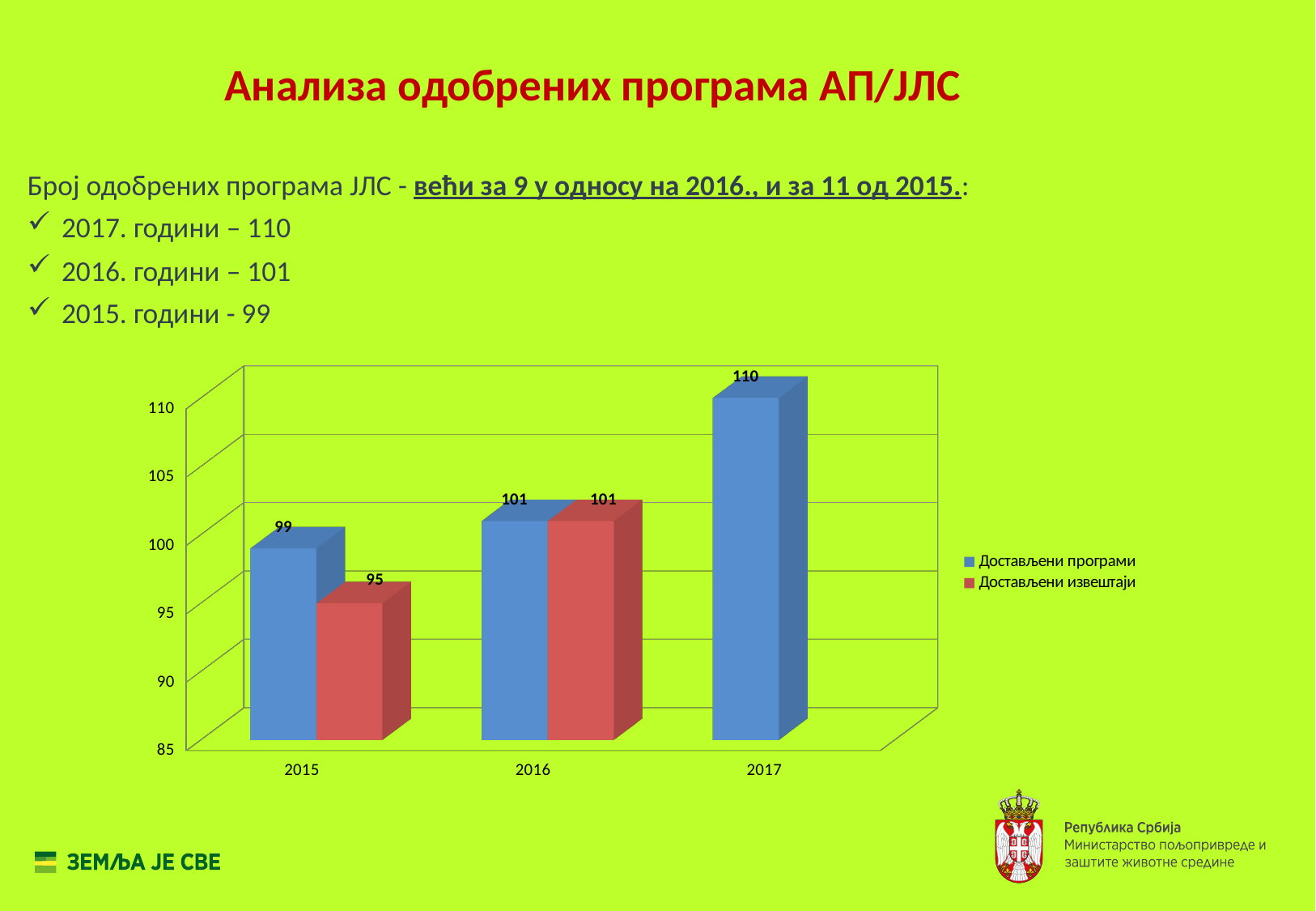
Which is larger in 2015: Достављени програми or Достављени извештаји? Достављени програми How many series does the legend list? 2 What is the value of Достављени програми for 2015? 99 What is the value of Достављени извештаји for 2015? 95 Do the values for Достављени програми rise or fall from 2015 to 2017? rise What is the difference between Достављени програми in 2017 and in 2016? 9 Which year has the highest value for Достављени програми? 2017 What is the difference between Достављени програми and Достављени извештаји in 2015? 4 Which year has the lowest value for Достављени програми? 2015 What kind of chart is shown on the slide? bar chart What is the value of Достављени програми for 2017? 110 What is the value of Достављени извештаји for 2016? 101